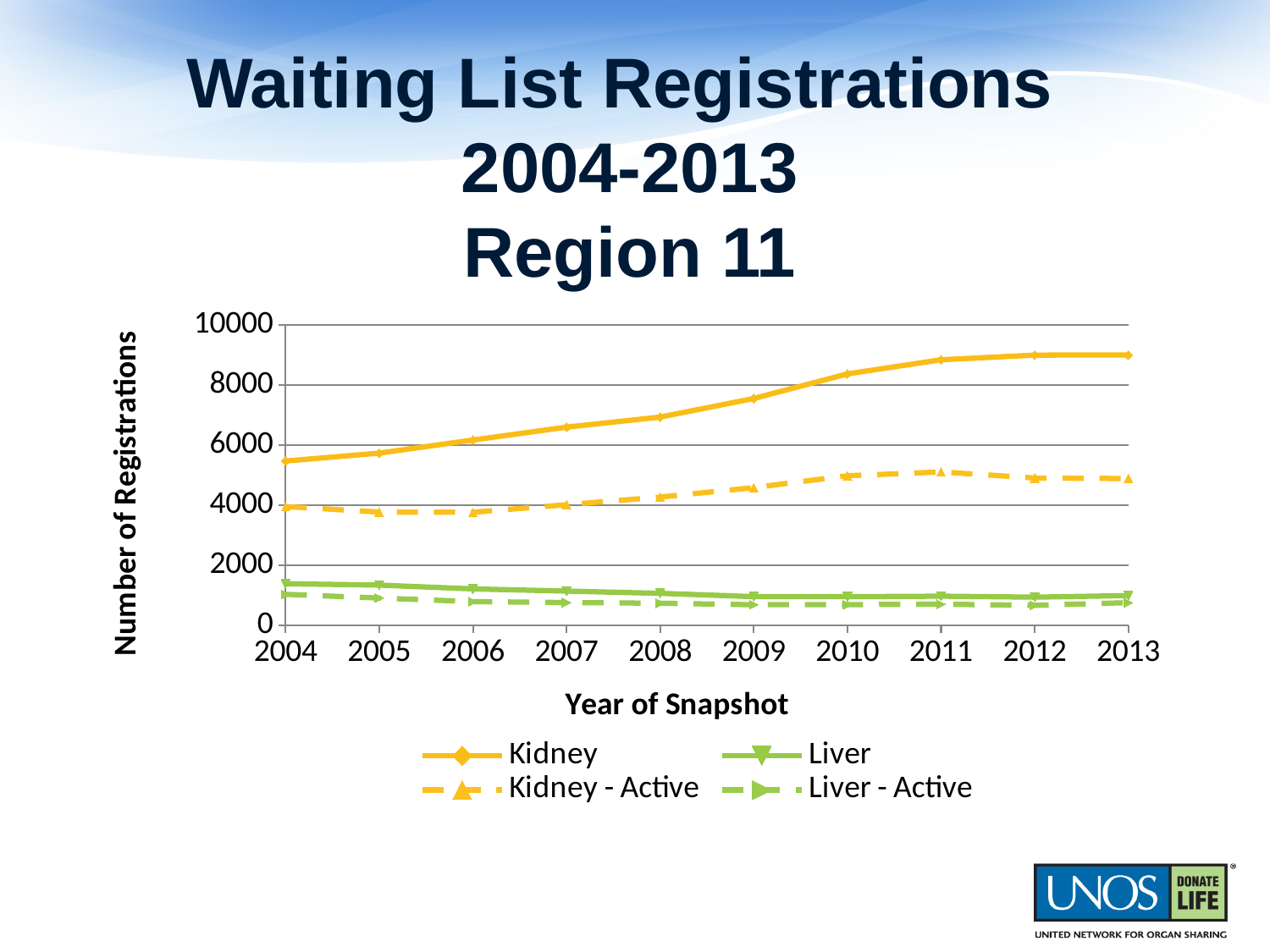
How many years are plotted along the x axis? 10 Is the Liver value for 2004 greater or less than 2000? less In 2010, which series is larger, Kidney or Liver? Kidney In which year is the Kidney series at its lowest? 2004 Is the Kidney - Active value for 2011 greater or less than 4000? greater Does the Kidney series rise or fall from 2004 to 2013? rise Does the Liver series rise or fall from 2004 to 2009? fall What is the title of the y axis? Number of Registrations Is the Kidney value for 2004 greater or less than 6000? less What kind of chart is shown on the slide? line chart How many series does the legend list? 4